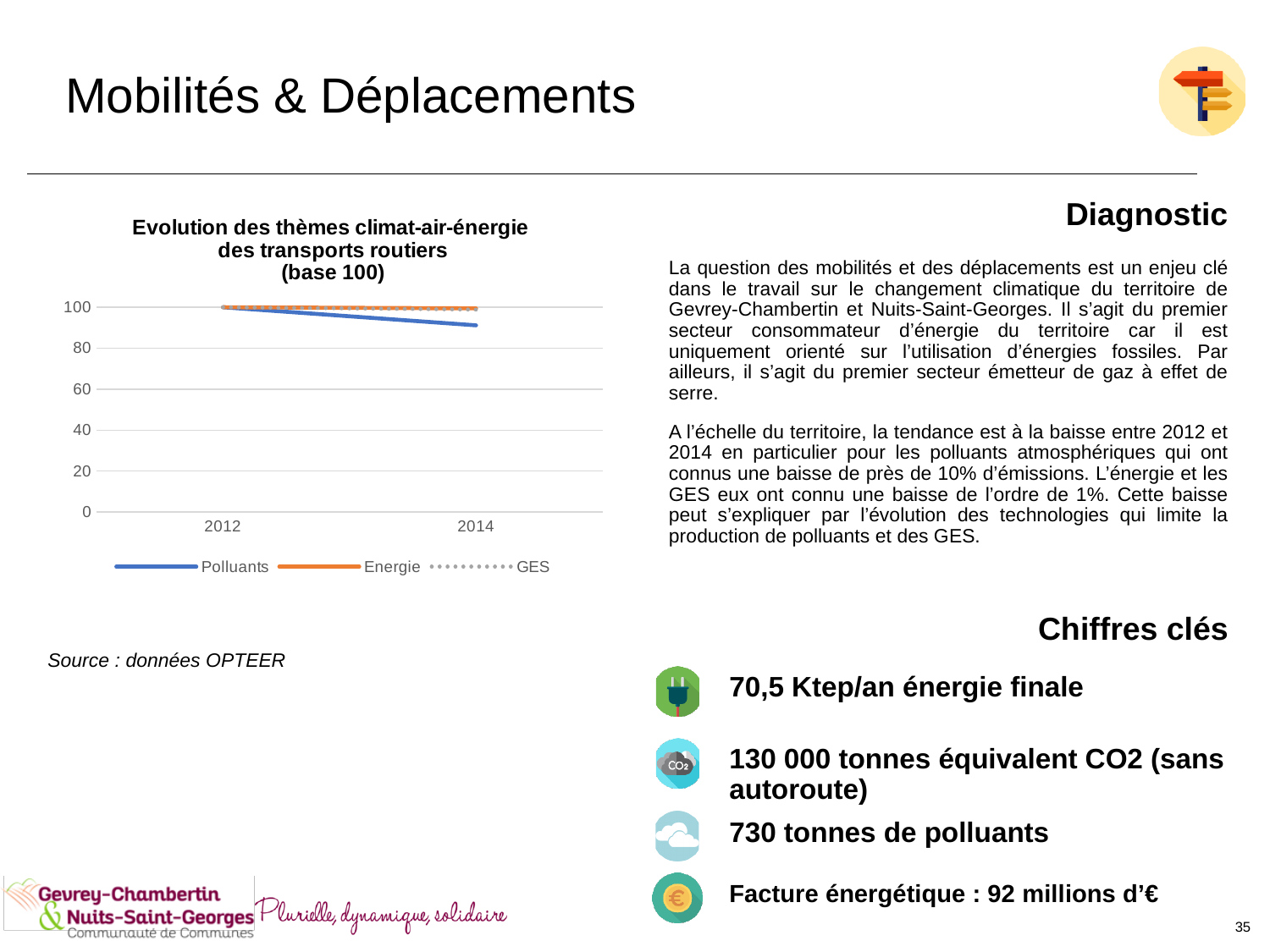
Which series are listed in the chart legend? Polluants, Energie, GES Is the value for Energie in 2014 greater or less than 80? greater In 2014, which is larger: the value for Energie or the value for Polluants? Energie Which series has the lowest value in 2014? Polluants Does the Polluants series rise or fall from 2012 to 2014? fall What kind of chart is shown on the slide? line chart Which years are shown on the x axis of the chart? 2012 and 2014 Is the value for Polluants in 2014 greater or less than 100? less What is the value of the Polluants series in 2012? 100 Is the value for Polluants in 2014 greater or less than 80? greater How many series does the chart legend list? 3 How many years are shown on the x axis of the chart? 2